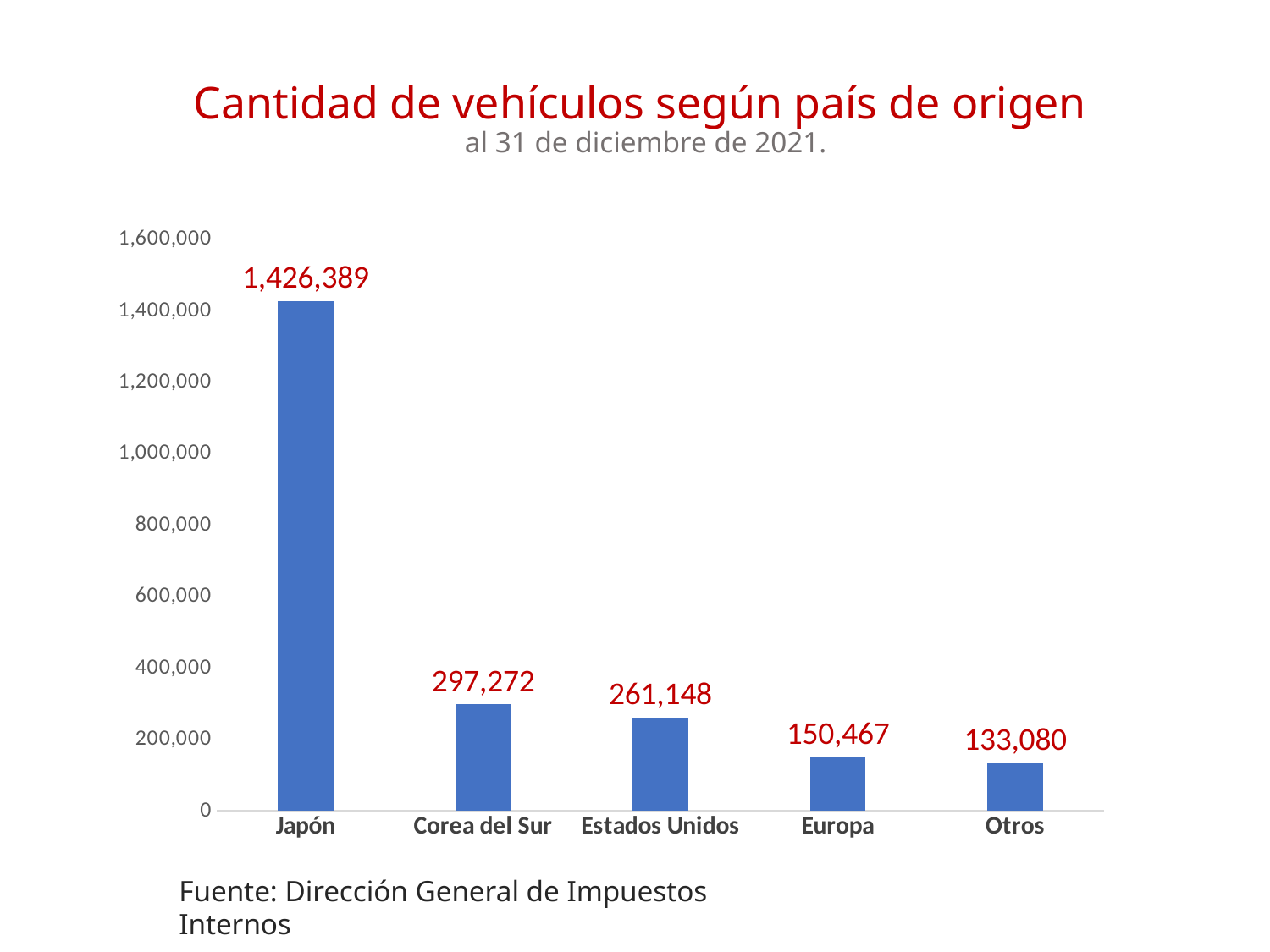
What is the value for Europa? 150,467 Which category has the highest value? Japón What is the value for Japón? 1,426,389 Which category has the lowest value? Otros How many categories are shown on the chart? 5 Which is larger, the value for Europa or the value for Otros? Europa What is the value for Corea del Sur? 297,272 What is the title of the chart? Cantidad de vehículos según país de origen What is the value for Otros? 133,080 What is the difference between the values for Corea del Sur and Estados Unidos? 36,124 What is the value for Estados Unidos? 261,148 What kind of chart is shown on the slide? Bar chart